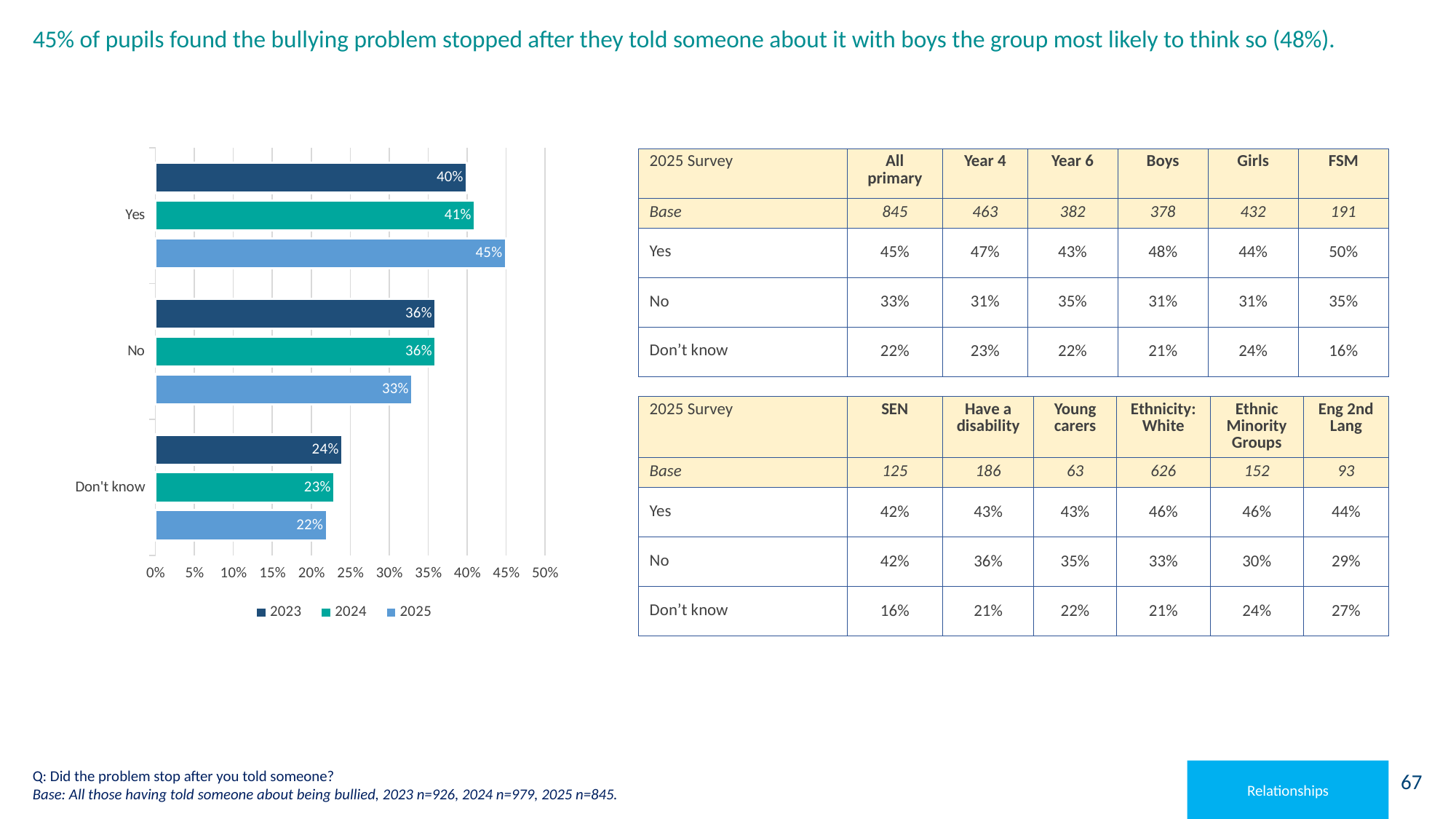
Which category has the highest value for the 2025 series on the bar chart? Yes What is the value for 'No' in 2024 on the bar chart? 36% What is the value for 'Don't know' in 2023 on the bar chart? 24% Which is larger on the bar chart: the 2023 value for 'No' or the 2025 value for 'No'? 2023 Is the 2025 value for 'Don't know' on the bar chart greater or less than 25%? less What is the difference between the 2025 and 2023 values for 'Yes' on the bar chart? 5% Which years are listed in the legend of the bar chart? 2023, 2024, 2025 Which category has the lowest value for the 2023 series on the bar chart? Don't know How many series does the legend of the bar chart list? 3 How many categories are shown on the bar chart? 3 What is the value for 'Yes' in 2025 on the bar chart? 45% What kind of chart is shown on the slide? Bar chart